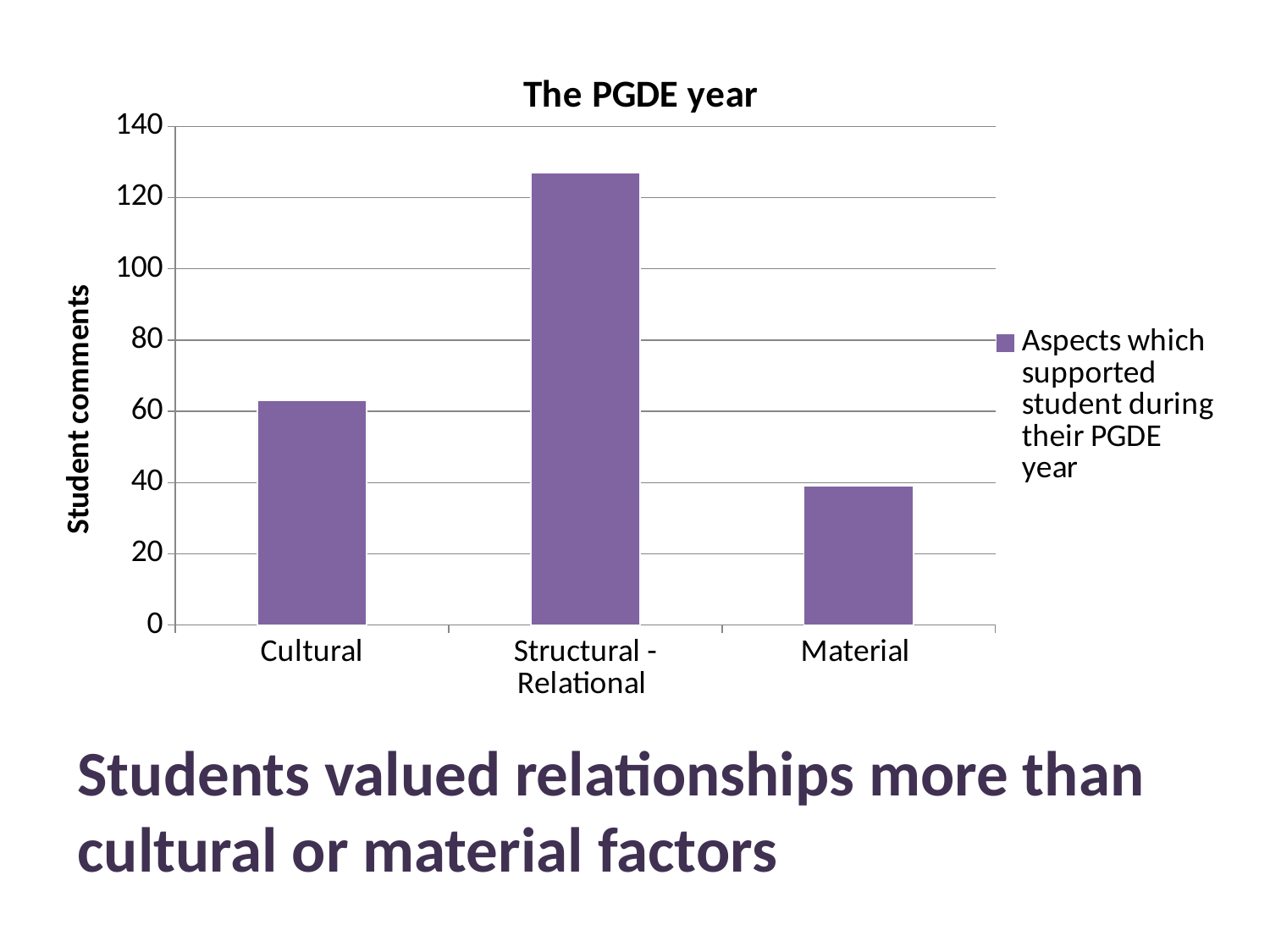
Is the value for Structural - Relational greater or less than 120? greater How many categories are shown on the x axis of the chart? 3 What is the label of the y axis? Student comments Which category has the lowest number of student comments? Material What is the title of the chart? The PGDE year How many series does the chart's legend list? 1 Is the value for Cultural greater or less than 80? less Which has more student comments, Cultural or Material? Cultural Is the value for Cultural greater or less than 60? greater What kind of chart is shown on the slide? bar chart Which category has the highest number of student comments? Structural - Relational